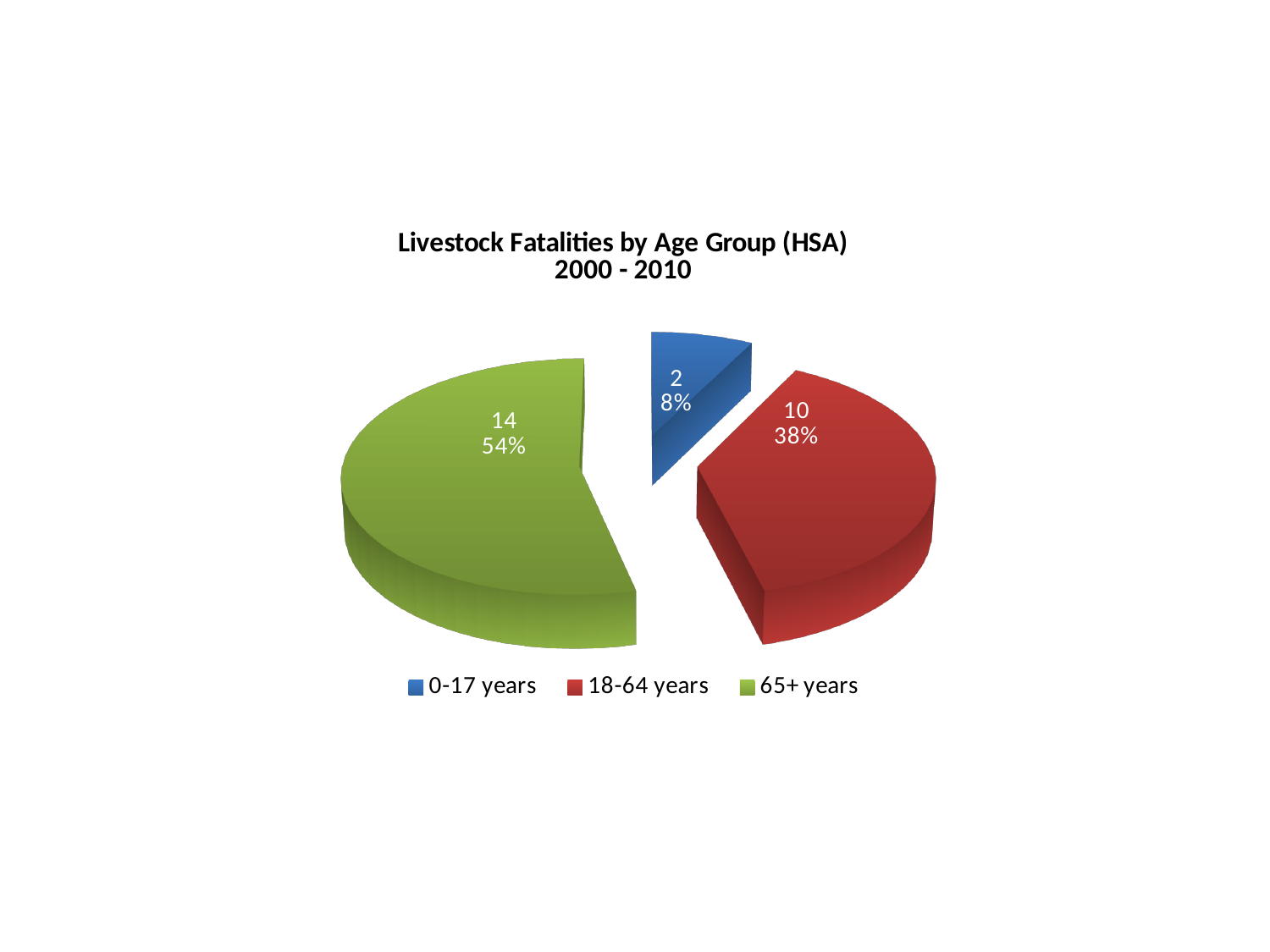
What kind of chart is shown on the slide? Pie chart What is the title of the chart? Livestock Fatalities by Age Group (HSA) 2000 - 2010 Which age group has the lowest number of fatalities? 0-17 years Which age group has the highest number of fatalities? 65+ years What share of the pie does the 65+ years slice represent? 54% Which has more fatalities, the 18-64 years group or the 0-17 years group? 18-64 years How many livestock fatalities are shown for the 18-64 years age group? 10 How many livestock fatalities are shown for the 0-17 years age group? 2 How many age groups are shown in the pie chart? 3 What is the difference in fatalities between the 65+ years and 18-64 years groups? 4 What share of the pie does the 0-17 years slice represent? 8% How many livestock fatalities are shown for the 65+ years age group? 14